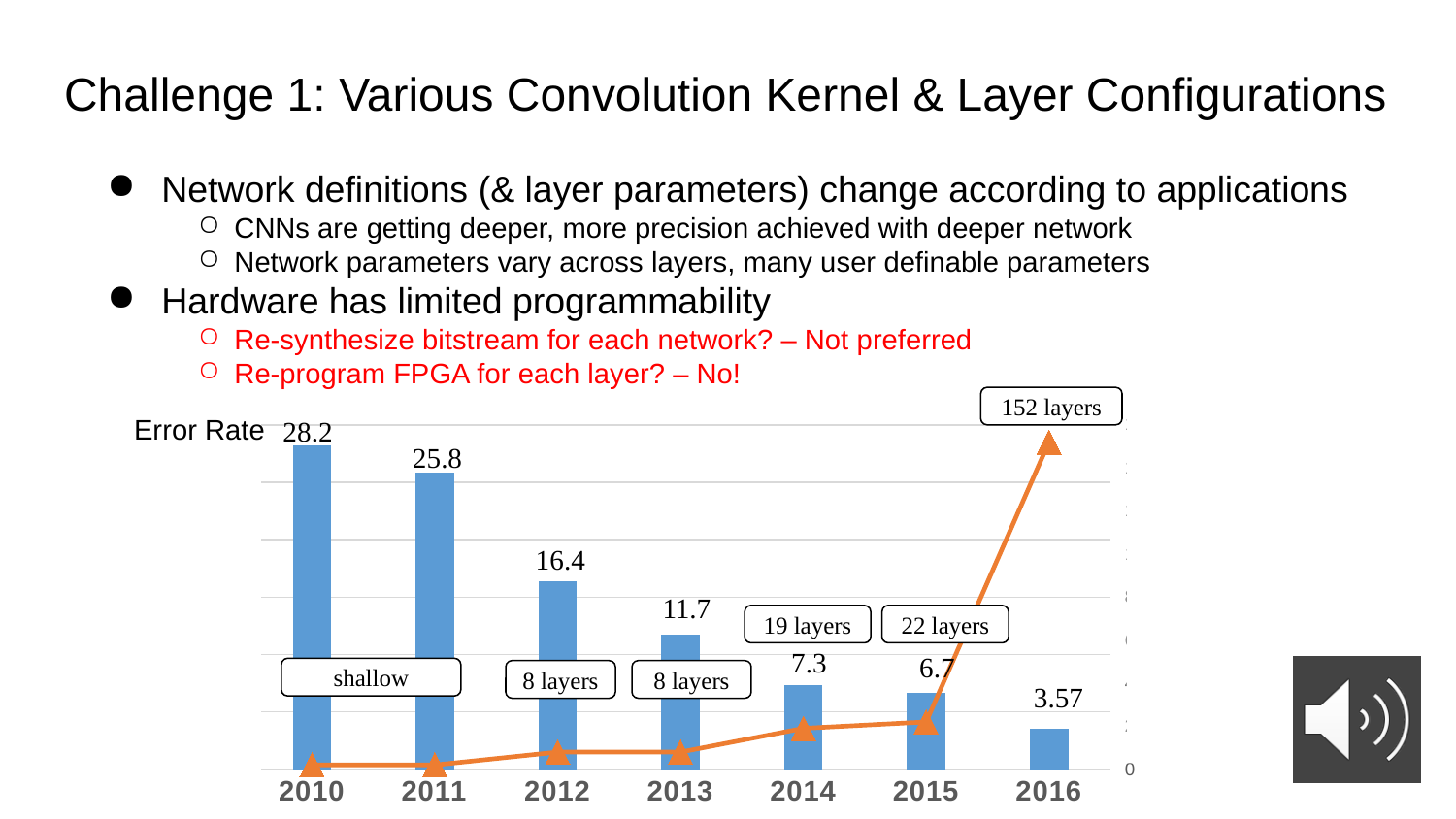
What is the difference between the error rates for 2011 and 2012? 9.4 What is the error rate shown for 2013? 11.7 What is the error rate shown for 2016? 3.57 Do the error rate bars rise or fall from 2010 to 2016? fall What is the difference between the error rates for 2014 and 2015? 0.6 What kind of chart is used to show the error rates? bar chart How many years are shown on the x axis? 7 Which year has the highest error rate? 2010 How many layers does the label above the 2016 point on the orange line indicate? 152 layers Which year has a larger error rate, 2012 or 2014? 2012 Which year has the lowest error rate? 2016 What is the error rate shown for 2010? 28.2